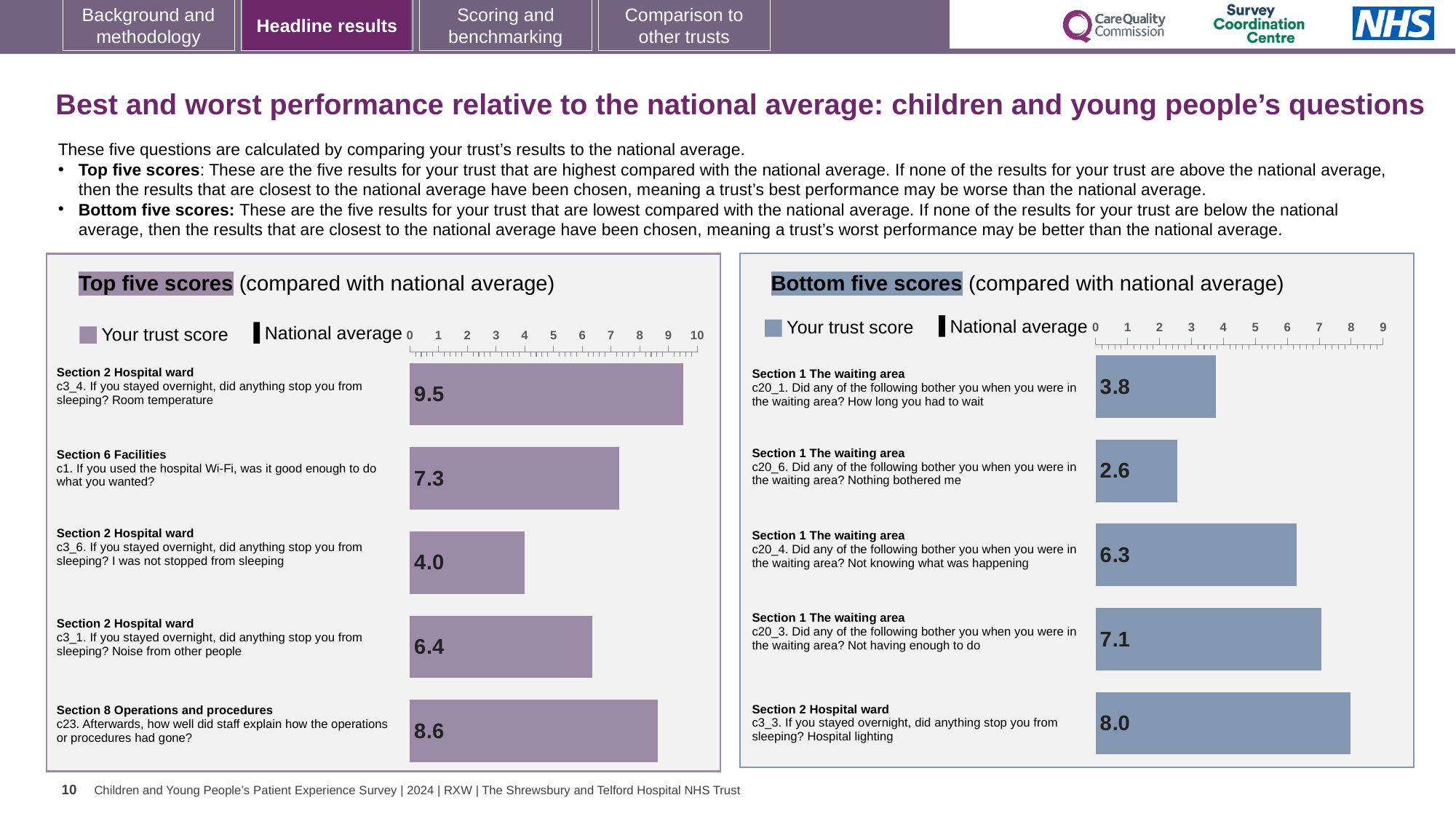
In the Bottom five scores chart, what is the difference between the trust scores for c20_3 (not having enough to do) and c20_1 (how long you had to wait)? 3.3 In the Bottom five scores chart, what is the trust score for c20_6 (nothing bothered me in the waiting area)? 2.6 In the Bottom five scores chart, which question has the lowest trust score? c20_6. Did any of the following bother you when you were in the waiting area? Nothing bothered me In the Top five scores chart, which has the larger trust score: c23 (how well staff explained operations) or c3_1 (noise from other people)? c23. Afterwards, how well did staff explain how the operations or procedures had gone? In the Bottom five scores chart, what is the trust score for c3_3 (hospital lighting stopping sleep)? 8.0 What type of chart is the Top five scores chart? Bar chart In the Top five scores chart, which question has the highest trust score? c3_4. If you stayed overnight, did anything stop you from sleeping? Room temperature How many questions are plotted in the Bottom five scores chart? 5 How many series does the legend of the Bottom five scores chart list? 2 In the Top five scores chart, which question has the lowest trust score? c3_6. If you stayed overnight, did anything stop you from sleeping? I was not stopped from sleeping In the Top five scores chart, what is the trust score for c3_4 (room temperature stopping sleep)? 9.5 In the Top five scores chart, what is the trust score for c1 (hospital Wi-Fi good enough)? 7.3